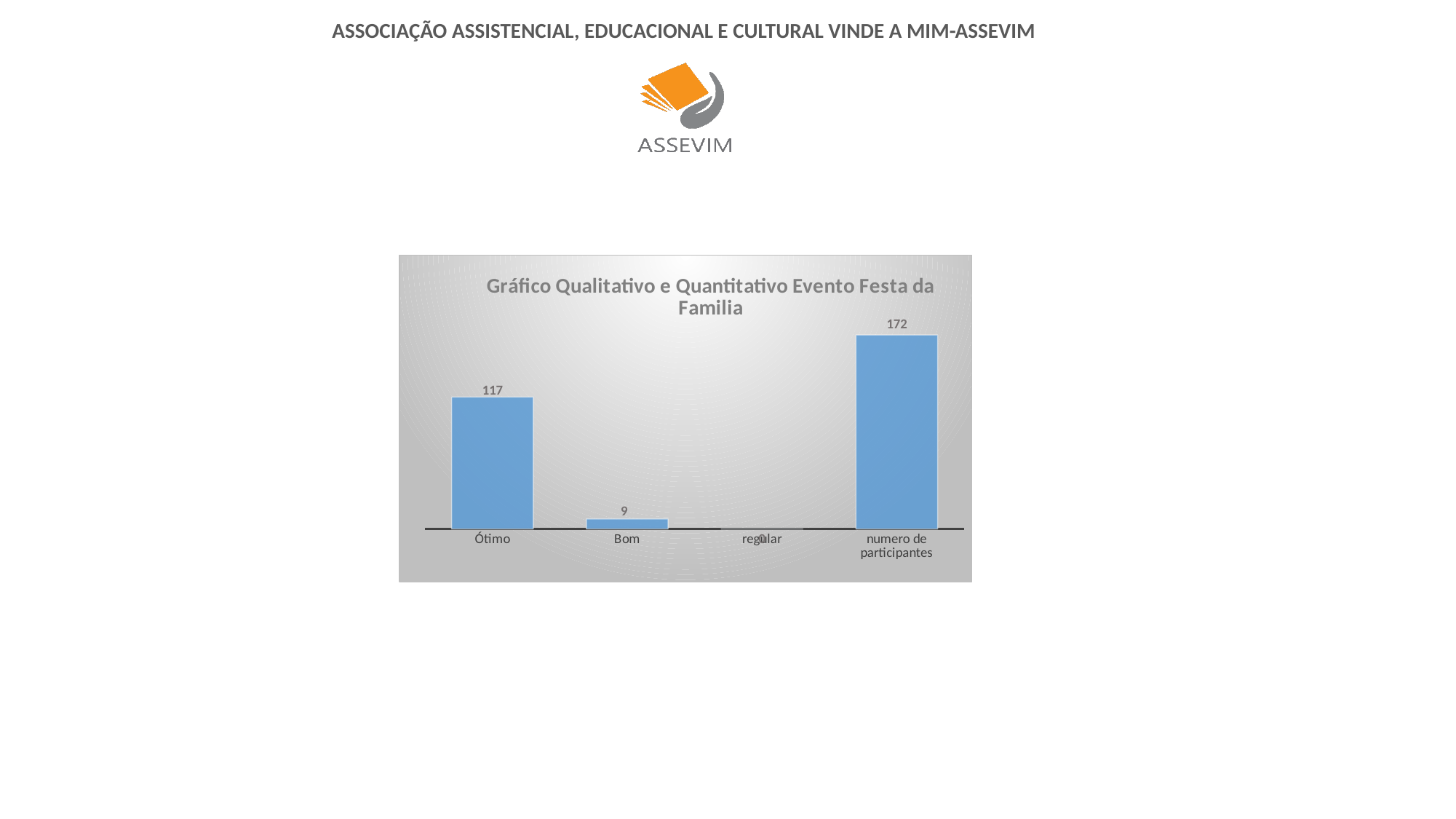
What is the value for regular? 0 How many categories are shown on the x axis? 4 What kind of chart is shown on the slide? bar chart What is the value for Ótimo? 117 What is the value for Bom? 9 Which category has the lowest value? regular What is the difference between the values for numero de participantes and Ótimo? 55 What is the difference between the values for Ótimo and Bom? 108 What is the title of the chart? Gráfico Qualitativo e Quantitativo Evento Festa da Familia Which category has the highest value? numero de participantes What is the value for numero de participantes? 172 Which is larger, the value for Ótimo or the value for Bom? Ótimo